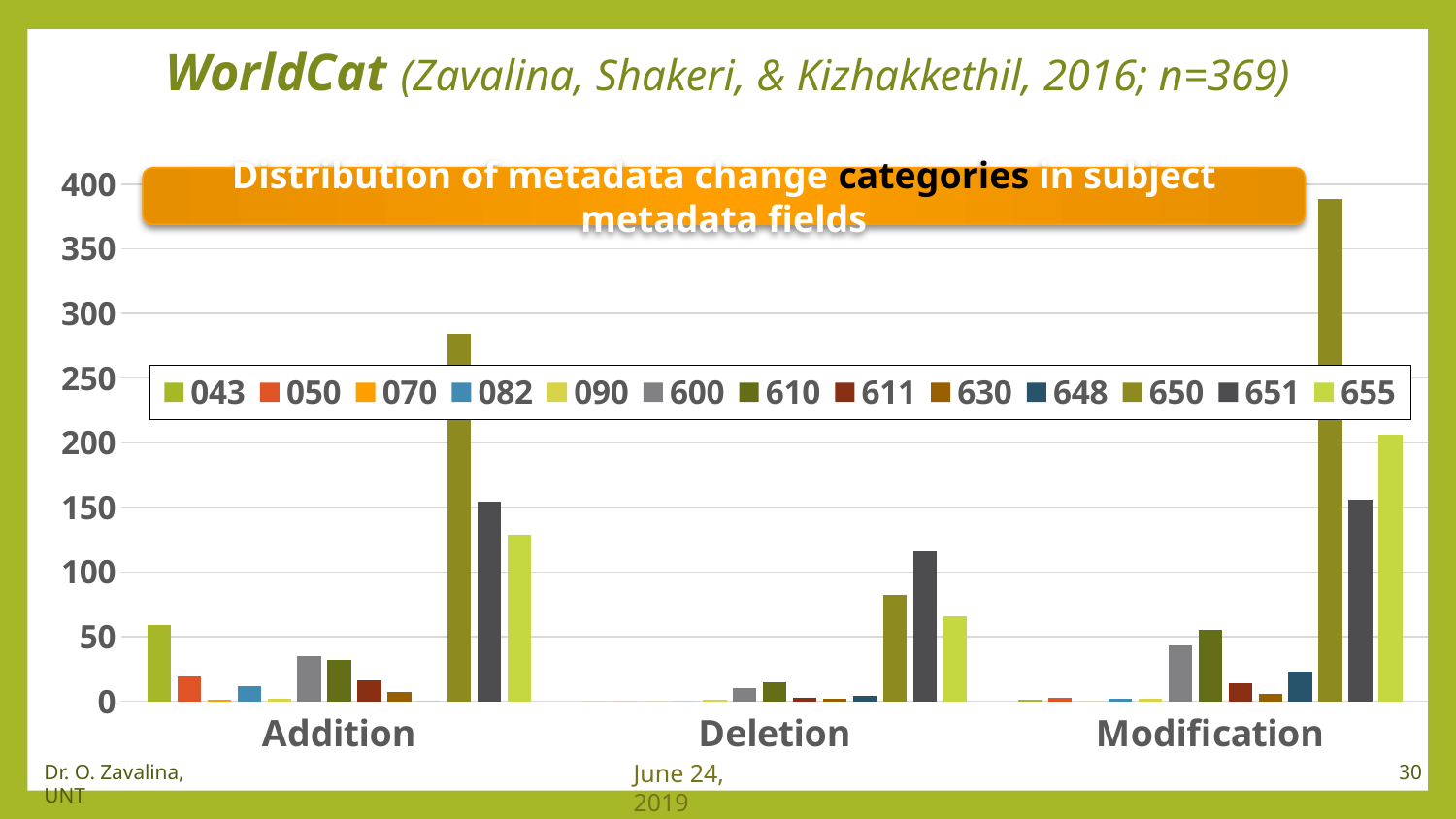
Which is larger: the value for series 650 in Addition or the value for series 650 in Modification? Modification Which series has the tallest bar in the Addition category? 650 Which is larger: the value for series 655 in Addition or the value for series 655 in Modification? Modification What kind of chart is shown on the slide? bar chart Is the value for series 650 in the Deletion category greater or less than 100? less How many series does the chart's legend list? 13 Which series has the tallest bar in the Modification category? 650 What is the title of the chart? Distribution of metadata change categories in subject metadata fields Is the value for series 651 in the Deletion category greater or less than 100? greater How many categories are shown on the x axis of the chart? 3 Is the value for series 650 in the Addition category greater or less than 250? greater